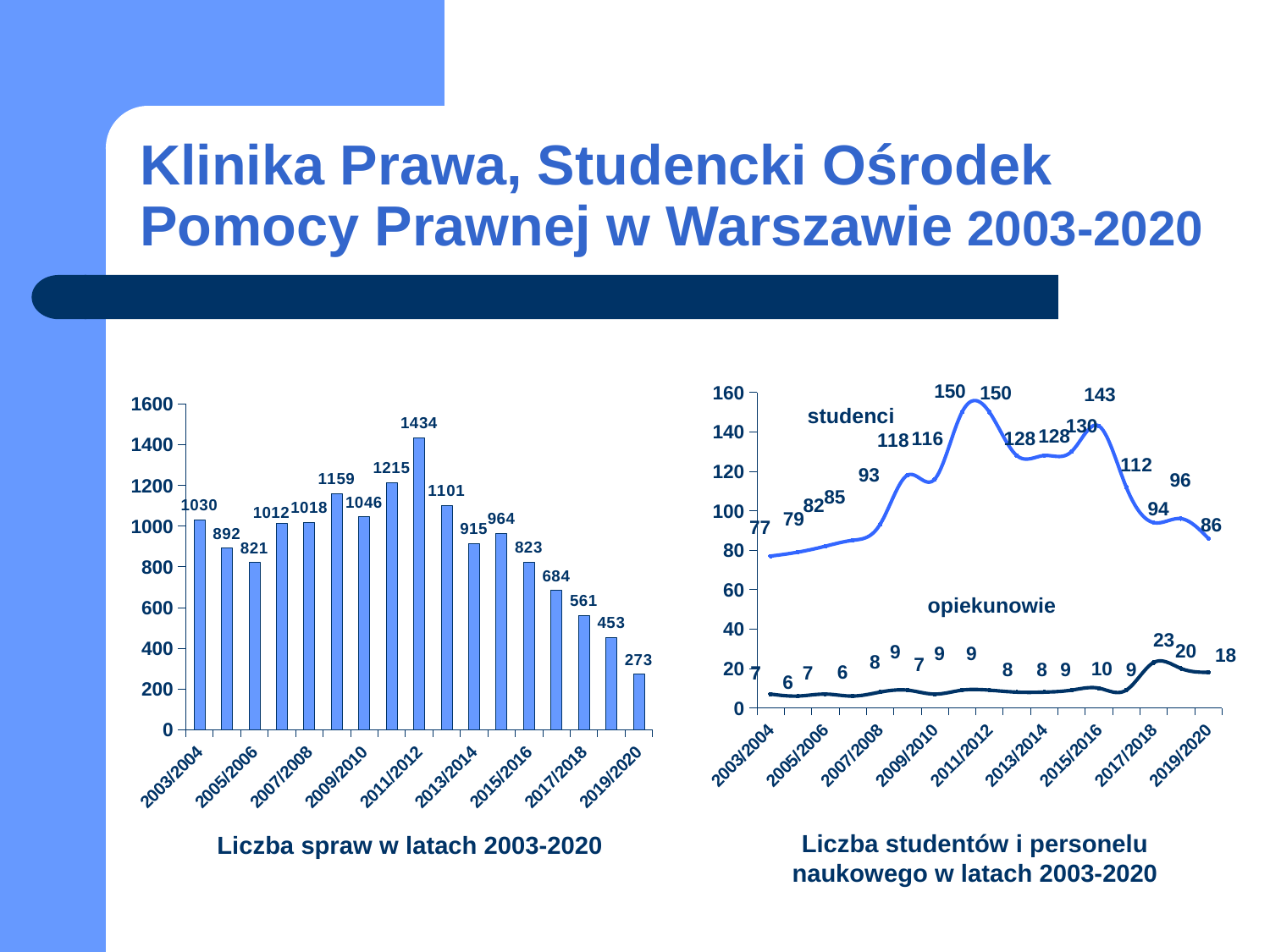
In the right chart 'Liczba studentów i personelu naukowego w latach 2003-2020', what is the value of 'studenci' for 2003/2004? 77 In the left chart 'Liczba spraw w latach 2003-2020', what is the value for 2019/2020? 273 In the left chart 'Liczba spraw w latach 2003-2020', how many bars are plotted? 17 In the right chart 'Liczba studentów i personelu naukowego w latach 2003-2020', how many series are plotted? 2 What kind of chart is the left chart, 'Liczba spraw w latach 2003-2020'? bar chart In the left chart 'Liczba spraw w latach 2003-2020', which year has the lowest number of cases? 2019/2020 In the right chart 'Liczba studentów i personelu naukowego w latach 2003-2020', what is the value of 'opiekunowie' for 2019/2020? 18 In the left chart 'Liczba spraw w latach 2003-2020', what is the value for 2011/2012? 1434 In the right chart 'Liczba studentów i personelu naukowego w latach 2003-2020', what is the highest value of the 'studenci' series? 150 In the right chart 'Liczba studentów i personelu naukowego w latach 2003-2020', what is the highest value of the 'opiekunowie' series? 23 In the left chart 'Liczba spraw w latach 2003-2020', what is the difference between the values for 2003/2004 and 2019/2020? 757 In the left chart 'Liczba spraw w latach 2003-2020', is the value for 2013/2014 greater or less than 1000? less